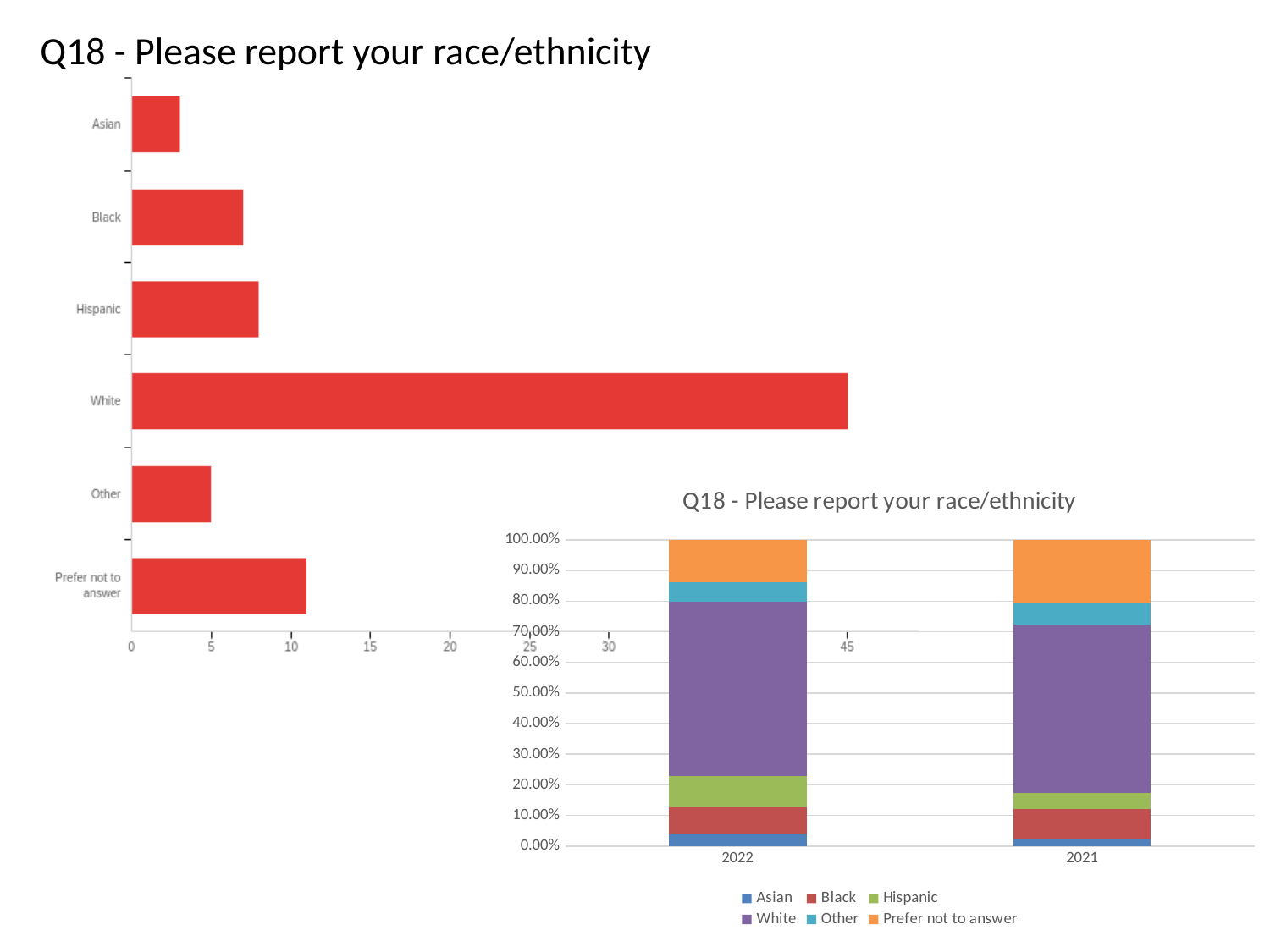
On the left horizontal bar chart, what is the value for White? 45 On the stacked bar chart on the right, which colour represents White in the legend? Purple On the left horizontal bar chart, which is larger, the value for Black or the value for Asian? Black How many series does the legend of the stacked bar chart on the right list? 6 On the left horizontal bar chart, is the value for Black greater or less than 10? less How many categories are shown on the left horizontal bar chart? 6 On the left horizontal bar chart, is the value for Prefer not to answer greater or less than 10? greater On the left horizontal bar chart, which category has the highest value? White On the left horizontal bar chart, which is larger, the value for Prefer not to answer or the value for Other? Prefer not to answer What kind of chart is the chart on the left of the slide? Bar chart On the left horizontal bar chart, which category has the lowest value? Asian How many categories are shown on the x axis of the stacked bar chart on the right? 2